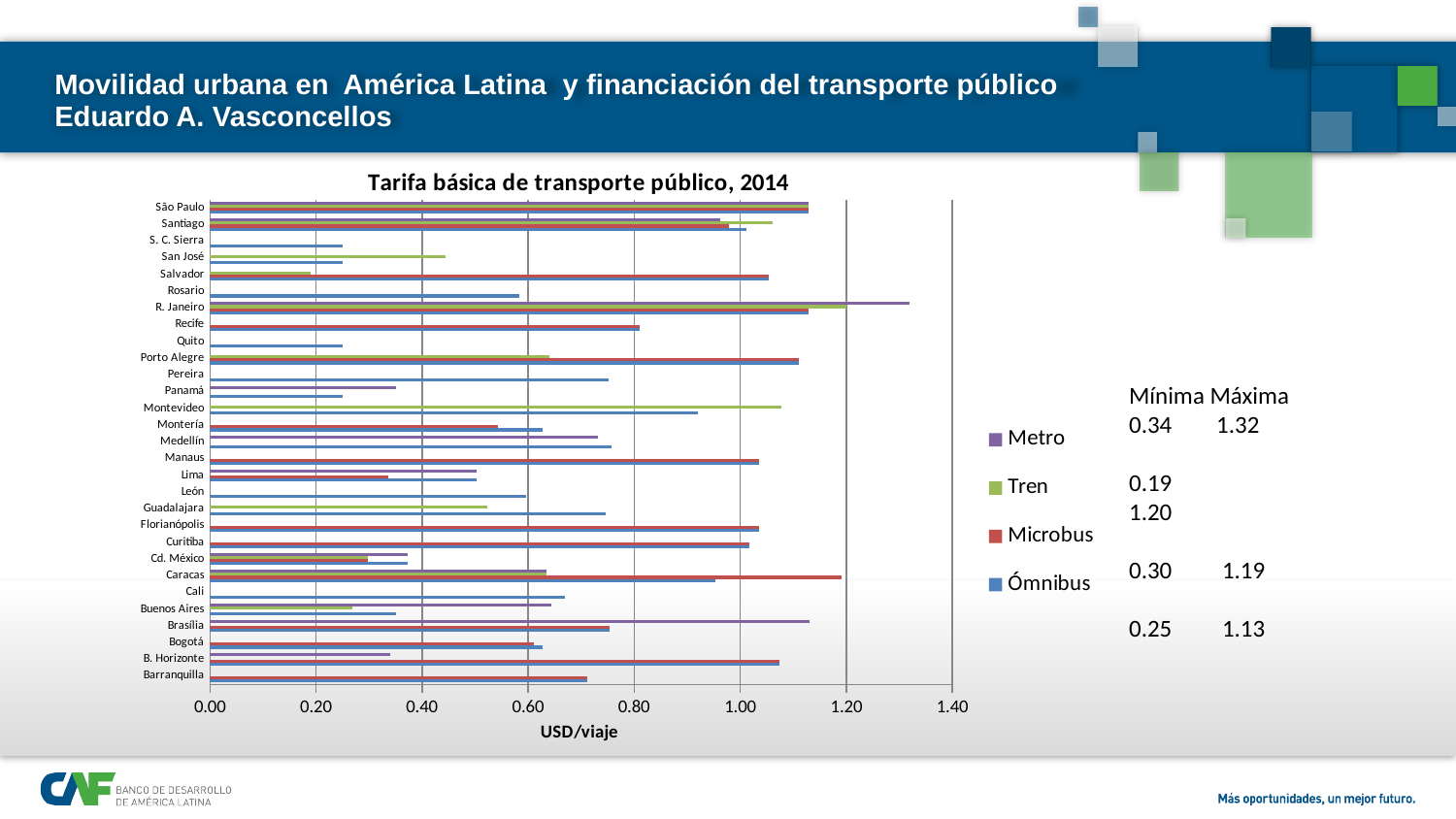
Is the Microbus fare for Caracas greater or less than 1.00? greater Is the Ómnibus fare for Quito greater or less than 0.40? less What kind of chart is shown on the slide? bar chart What is the title of the chart? Tarifa básica de transporte público, 2014 In Caracas, which is larger, the Microbus fare or the Ómnibus fare? Microbus How many series does the legend of the chart list? 4 According to the Mínima/Máxima table next to the legend, what is the maximum Metro fare? 1.32 Which city has the lowest Tren fare in the chart? Salvador How many cities are listed on the vertical axis of the chart? 29 What is the label of the horizontal axis of the chart? USD/viaje Is the Metro fare for R. Janeiro greater or less than 1.20? greater Which city has the highest Metro fare in the chart? R. Janeiro